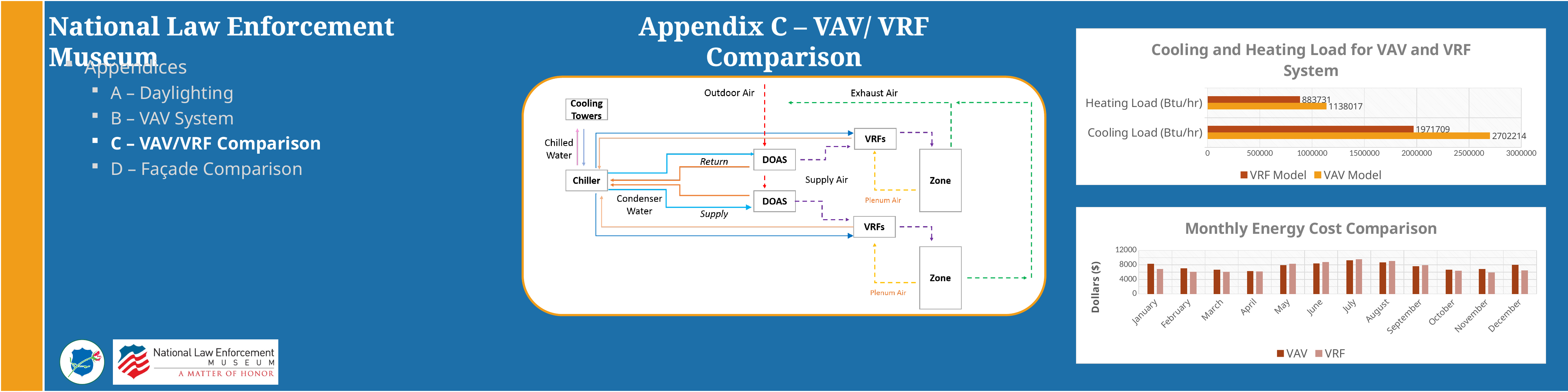
In the 'Monthly Energy Cost Comparison' chart, is the VRF value for April greater or less than 8000? less In the 'Cooling and Heating Load for VAV and VRF System' chart, which model has the larger Heating Load? VAV Model In the 'Cooling and Heating Load for VAV and VRF System' chart, what is the Cooling Load for the VAV Model? 2702214 In the 'Monthly Energy Cost Comparison' chart, is the VAV value for July greater or less than 8000? greater In the 'Cooling and Heating Load for VAV and VRF System' chart, what is the difference between the VAV Model and VRF Model Cooling Load? 730505 In the 'Cooling and Heating Load for VAV and VRF System' chart, how many series does the legend list? 2 In the 'Cooling and Heating Load for VAV and VRF System' chart, what is the Heating Load for the VAV Model? 1138017 What kind of chart is 'Monthly Energy Cost Comparison'? bar chart In the 'Cooling and Heating Load for VAV and VRF System' chart, what is the Heating Load for the VRF Model? 883731 In the 'Cooling and Heating Load for VAV and VRF System' chart, which bar has the highest value? Cooling Load (Btu/hr), VAV Model In the 'Monthly Energy Cost Comparison' chart, how many months are shown on the x axis? 12 What is the y-axis label of the 'Monthly Energy Cost Comparison' chart? Dollars ($)